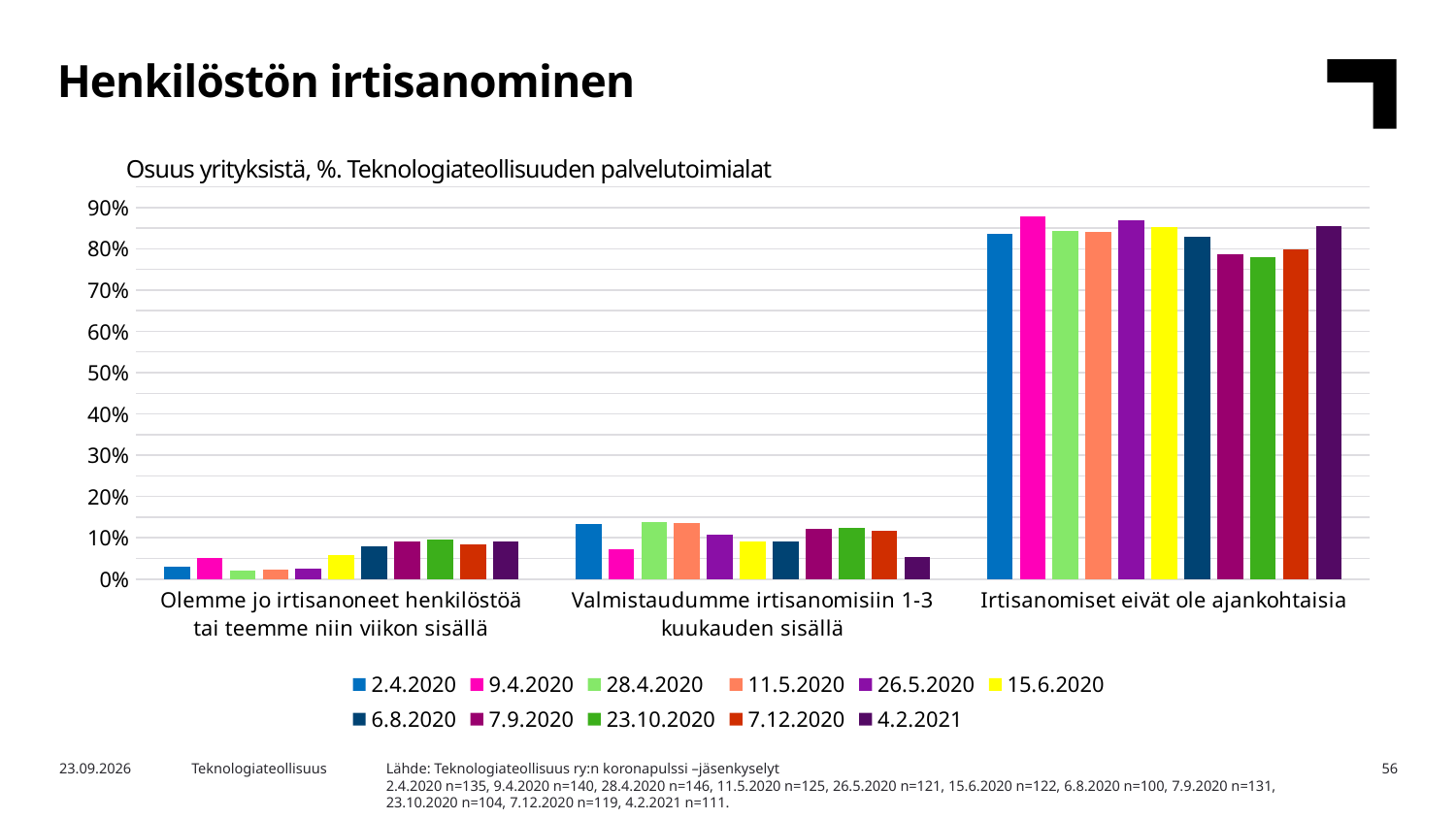
Is the value for 2.4.2020 in the category "Olemme jo irtisanoneet henkilöstöä tai teemme niin viikon sisällä" greater or less than 10%? less What is the subtitle shown above the chart? Osuus yrityksistä, %. Teknologiateollisuuden palvelutoimialat For the 2.4.2020 series, which category has the highest value? Irtisanomiset eivät ole ajankohtaisia Is the value for 2.4.2020 in the category "Valmistaudumme irtisanomisiin 1-3 kuukauden sisällä" greater or less than 10%? greater How many series does the legend list? 11 For the 2.4.2020 series, which category has the lowest value? Olemme jo irtisanoneet henkilöstöä tai teemme niin viikon sisällä How many categories are shown on the x axis? 3 What kind of chart is shown on the slide? Bar chart In the category "Valmistaudumme irtisanomisiin 1-3 kuukauden sisällä", which series has the lowest value? 4.2.2021 Is the value for 23.10.2020 in the category "Irtisanomiset eivät ole ajankohtaisia" greater or less than 70%? greater In the category "Olemme jo irtisanoneet henkilöstöä tai teemme niin viikon sisällä", which is larger: the value for 2.4.2020 or for 4.2.2021? 4.2.2021